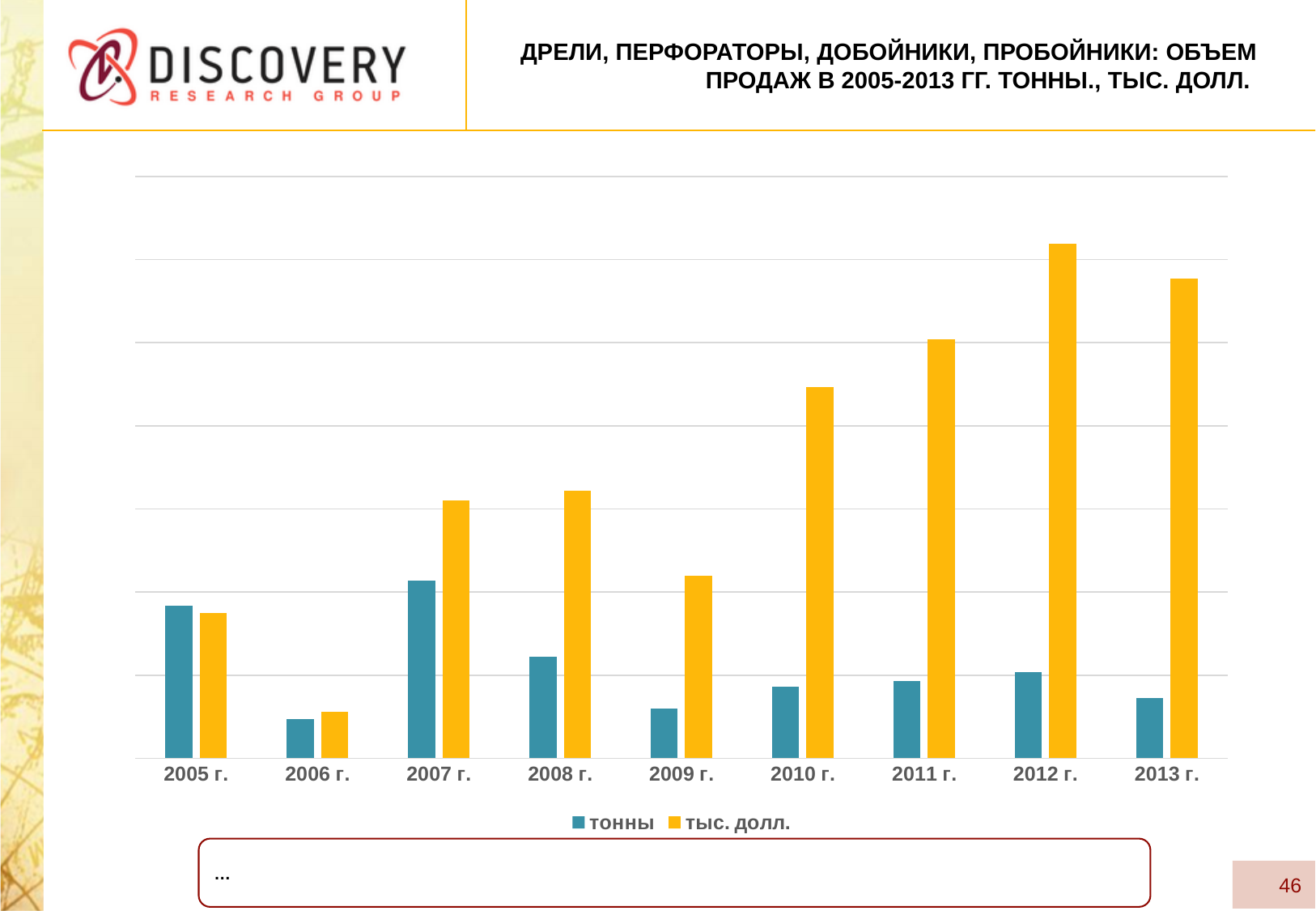
In which year is the value for тыс. долл. the lowest? 2006 г. Which year has the larger value for тыс. долл., 2010 г. or 2011 г.? 2011 г. In which year is the value for тонны the highest? 2007 г. What are the two entries in the chart legend? тонны and тыс. долл. In which year is the value for тыс. долл. the highest? 2012 г. In which year is the value for тонны the lowest? 2006 г. Which year has the larger value for тонны, 2012 г. or 2013 г.? 2012 г. Do the values for тыс. долл. rise or fall from 2009 г. to 2012 г.? Rise What kind of chart is shown on the slide? Bar chart How many years are shown on the x axis? 9 How many series does the legend list? 2 Which year has the larger value for тыс. долл., 2008 г. or 2009 г.? 2008 г.